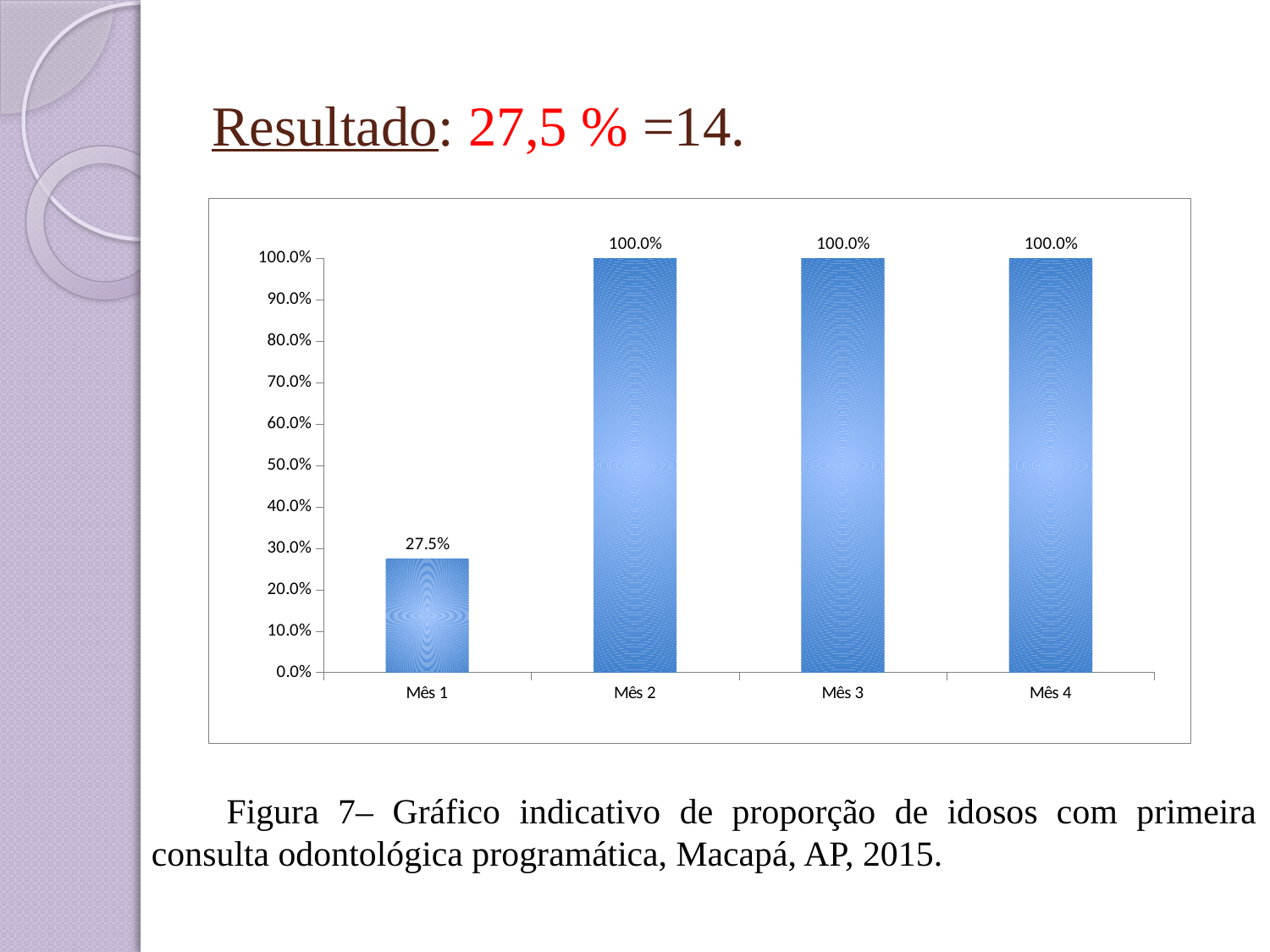
How many months are shown on the x axis? 4 What is the figure number given in the caption below the chart? Figura 7 What is the difference between the values for Mês 2 and Mês 1? 72.5% Is the value for Mês 1 greater or less than 30.0%? less What kind of chart is shown on the slide? bar chart What is the highest value shown on the y axis? 100.0% Do the values rise or fall from Mês 1 to Mês 2? rise Which is larger, the value for Mês 1 or the value for Mês 4? Mês 4 What is the value for Mês 3? 100.0% How many months have a value of 100.0%? 3 Which month has the lowest value? Mês 1 What is the value for Mês 1? 27.5%